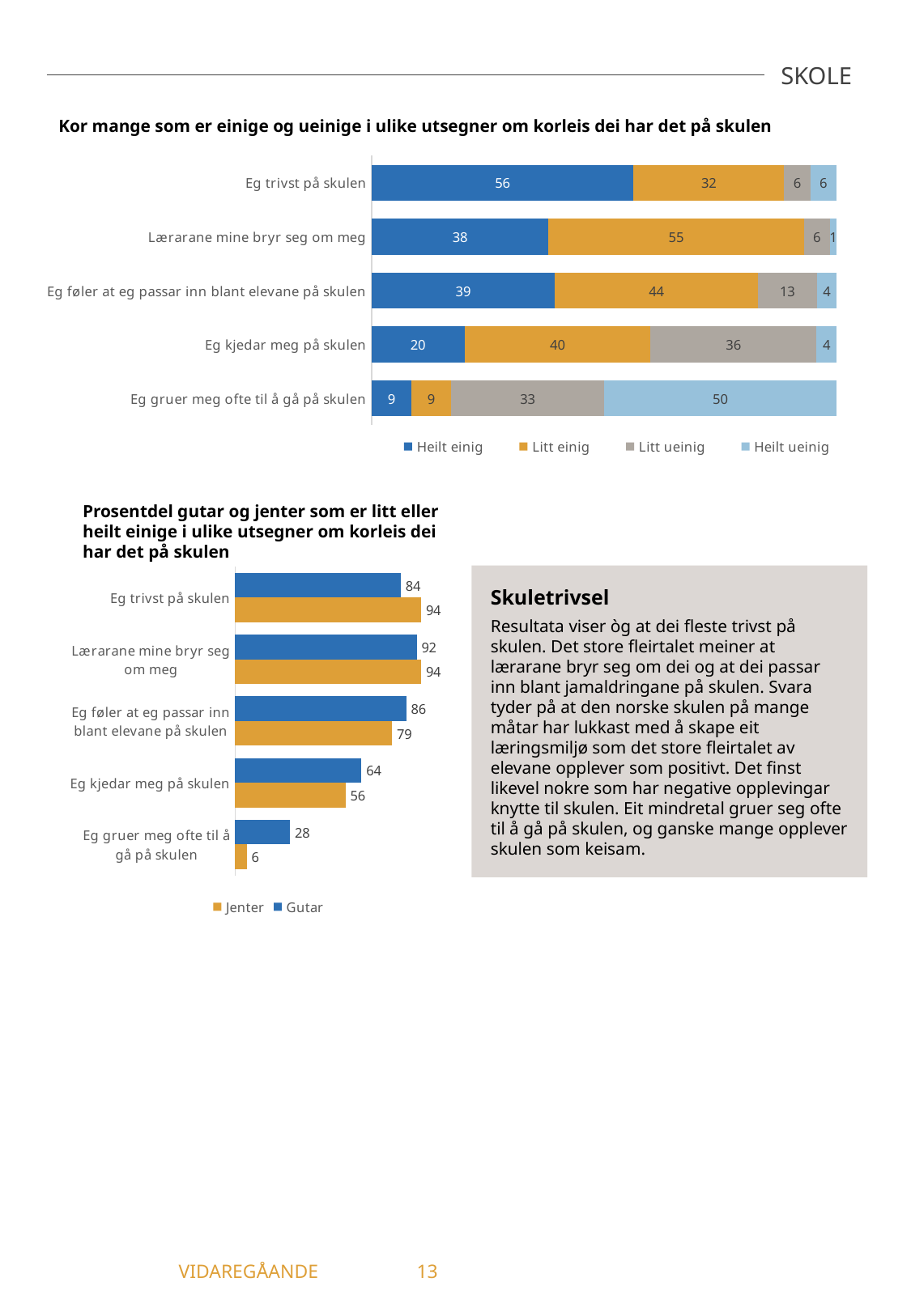
In the top chart, how many series does the legend list? 4 In the bottom chart, which is larger for 'Eg føler at eg passar inn blant elevane på skulen': the 'Gutar' value or the 'Jenter' value? Gutar In the top chart, which statement has the highest 'Litt ueinig' value? Eg kjedar meg på skulen In the bottom chart, how many statements (categories) are shown? 5 In the top chart, what is the 'Heilt ueinig' value for 'Eg gruer meg ofte til å gå på skulen'? 50 In the bottom chart 'Prosentdel gutar og jenter som er litt eller heilt einige i ulike utsegner om korleis dei har det på skulen', what is the 'Jenter' value for 'Eg trivst på skulen'? 94 In the bottom chart, what is the 'Gutar' value for 'Eg gruer meg ofte til å gå på skulen'? 28 In the bottom chart, what is the difference between the 'Gutar' and 'Jenter' values for 'Eg kjedar meg på skulen'? 8 What kind of chart is the top chart? Stacked bar chart In the top chart 'Kor mange som er einige og ueinige i ulike utsegner om korleis dei har det på skulen', what is the 'Heilt einig' value for 'Eg trivst på skulen'? 56 In the top chart, what is the 'Litt einig' value for 'Lærarane mine bryr seg om meg'? 55 In the top chart, what is the difference between the 'Heilt einig' and 'Litt einig' values for 'Eg kjedar meg på skulen'? 20